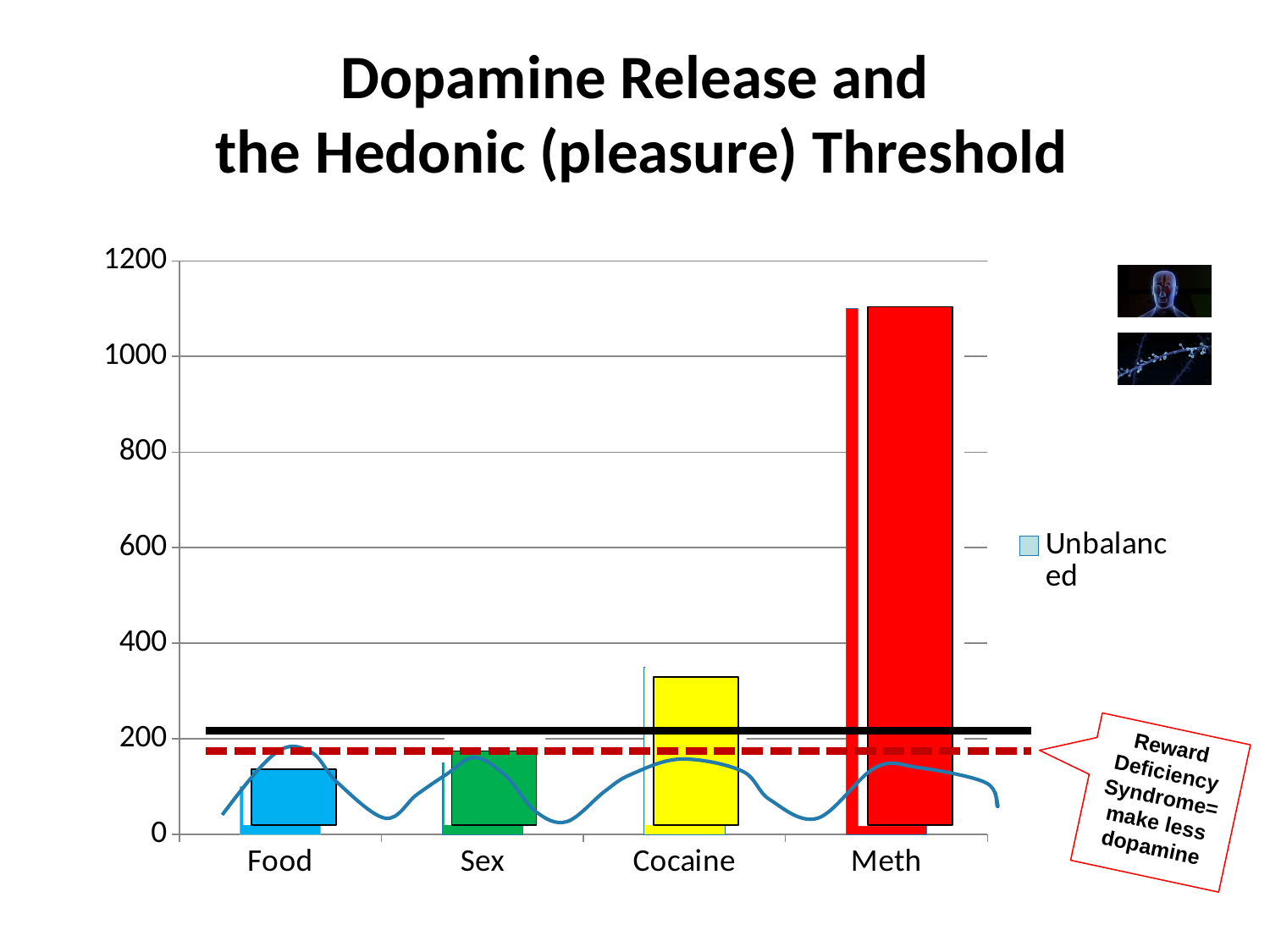
Which is larger, the value for Cocaine or the value for Sex? Cocaine What is the title of the chart on the slide? Dopamine Release and the Hedonic (pleasure) Threshold What series name is listed in the chart legend? Unbalanced Which category has the lowest bar in the chart? Food What kind of chart is shown on the slide? bar chart Which category has the highest bar in the chart? Meth How many series does the chart legend list? 1 Is the value for Meth greater or less than 1000? greater Do the bar values rise or fall moving from Food to Meth along the x axis? rise Is the value for Cocaine greater or less than 200? greater How many categories are shown on the x axis of the chart? 4 Is the value for Food greater or less than 200? less